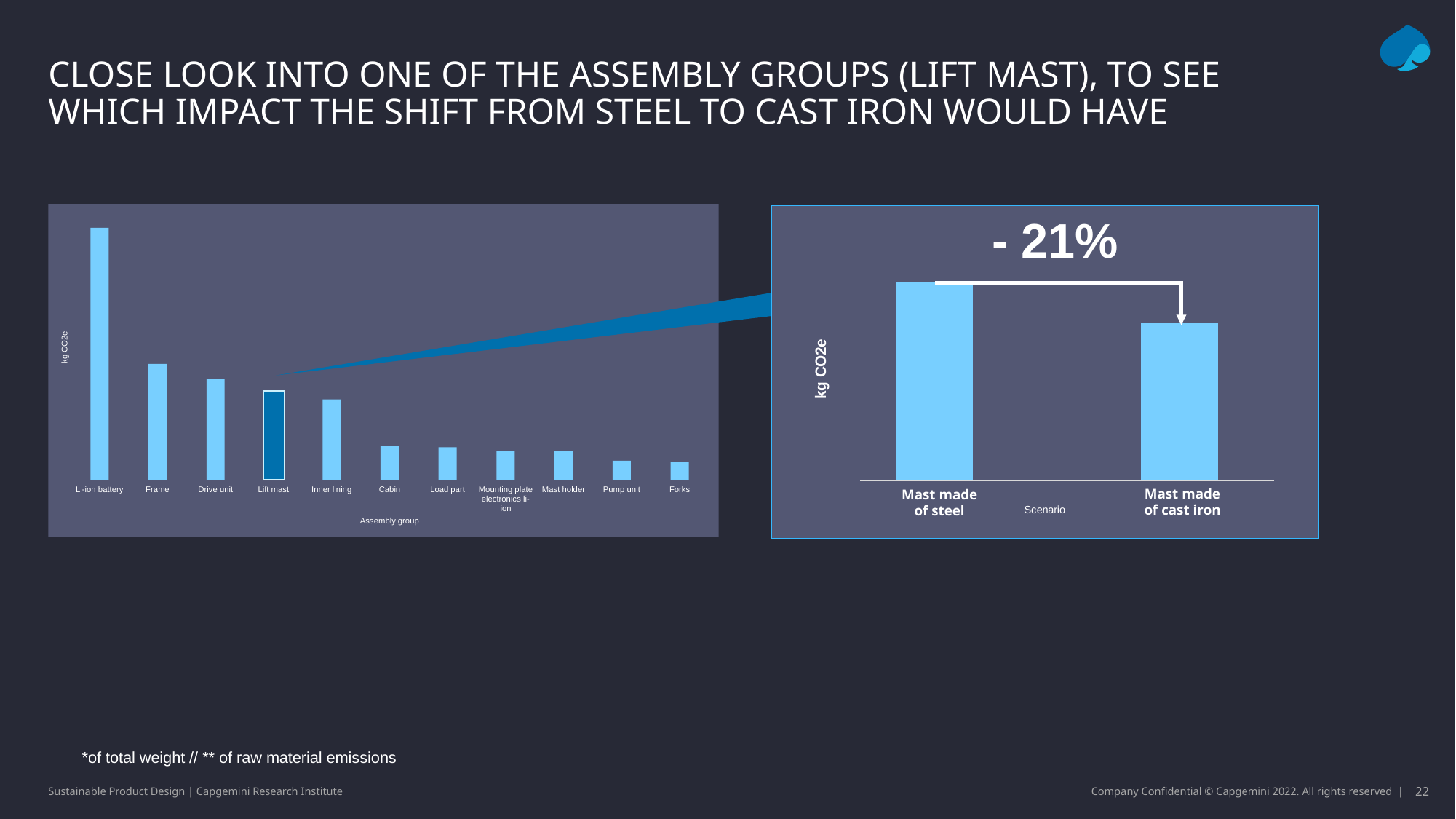
In the left chart (Assembly group), how many assembly groups are plotted? 11 In the left chart (Assembly group), which bar is highlighted in a darker blue than the others? Lift mast In the right chart (Scenario), which scenario has the higher kg CO2e value, Mast made of steel or Mast made of cast iron? Mast made of steel In the left chart (Assembly group), do the values generally rise or fall from left to right along the x axis? fall In the right chart (Scenario), how many scenarios are plotted? 2 In the left chart (Assembly group), which assembly group has the highest kg CO2e value? Li-ion battery In the left chart (Assembly group), which has a higher kg CO2e value, Cabin or Inner lining? Inner lining In the right chart (Scenario), what percentage change is shown from Mast made of steel to Mast made of cast iron? - 21% What is the label of the y axis on the right chart (Scenario)? kg CO2e In the left chart (Assembly group), which has a higher kg CO2e value, Frame or Lift mast? Frame In the left chart (Assembly group), which assembly group has the lowest kg CO2e value? Forks What kind of chart is the left chart (Assembly group)? bar chart